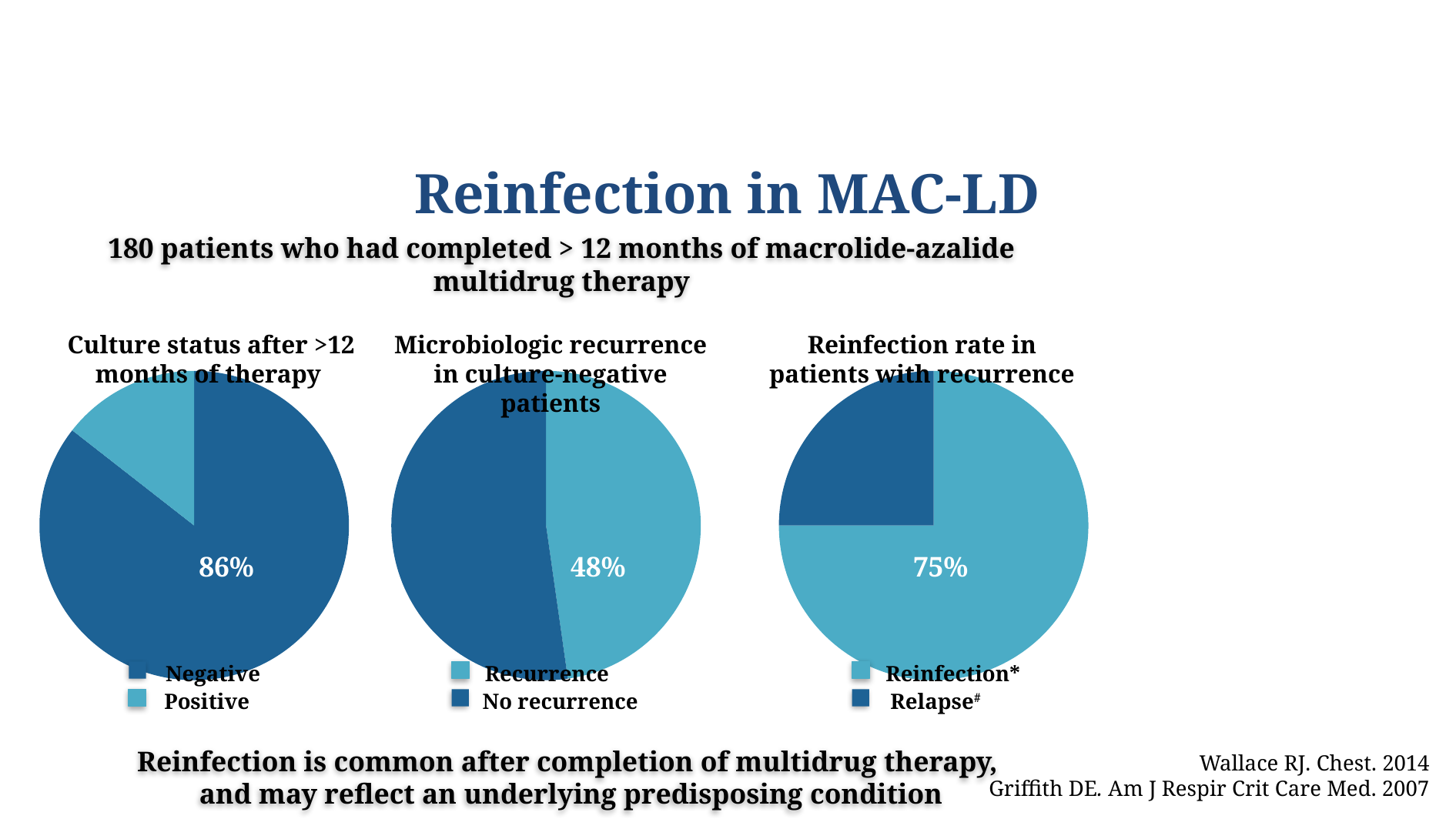
How many slices does the 'Reinfection rate in patients with recurrence' pie chart have? 2 How many pie charts are shown on the slide? 3 In the 'Reinfection rate in patients with recurrence' chart, which category has the smallest slice? Relapse# What are the two legend entries of the 'Microbiologic recurrence in culture-negative patients' chart? Recurrence, No recurrence In the 'Reinfection rate in patients with recurrence' chart, what percentage of patients had reinfection? 75% In the 'Culture status after >12 months of therapy' chart, what percentage of patients were culture negative? 86% In the 'Reinfection rate in patients with recurrence' chart, which category has the largest slice? Reinfection* In the 'Culture status after >12 months of therapy' chart, which slice is larger, Negative or Positive? Negative How many legend entries does the 'Culture status after >12 months of therapy' chart list? 2 In the 'Microbiologic recurrence in culture-negative patients' chart, what percentage of patients had recurrence? 48% What kind of chart is used for 'Culture status after >12 months of therapy'? Pie chart In the 'Microbiologic recurrence in culture-negative patients' chart, which slice is larger, Recurrence or No recurrence? No recurrence